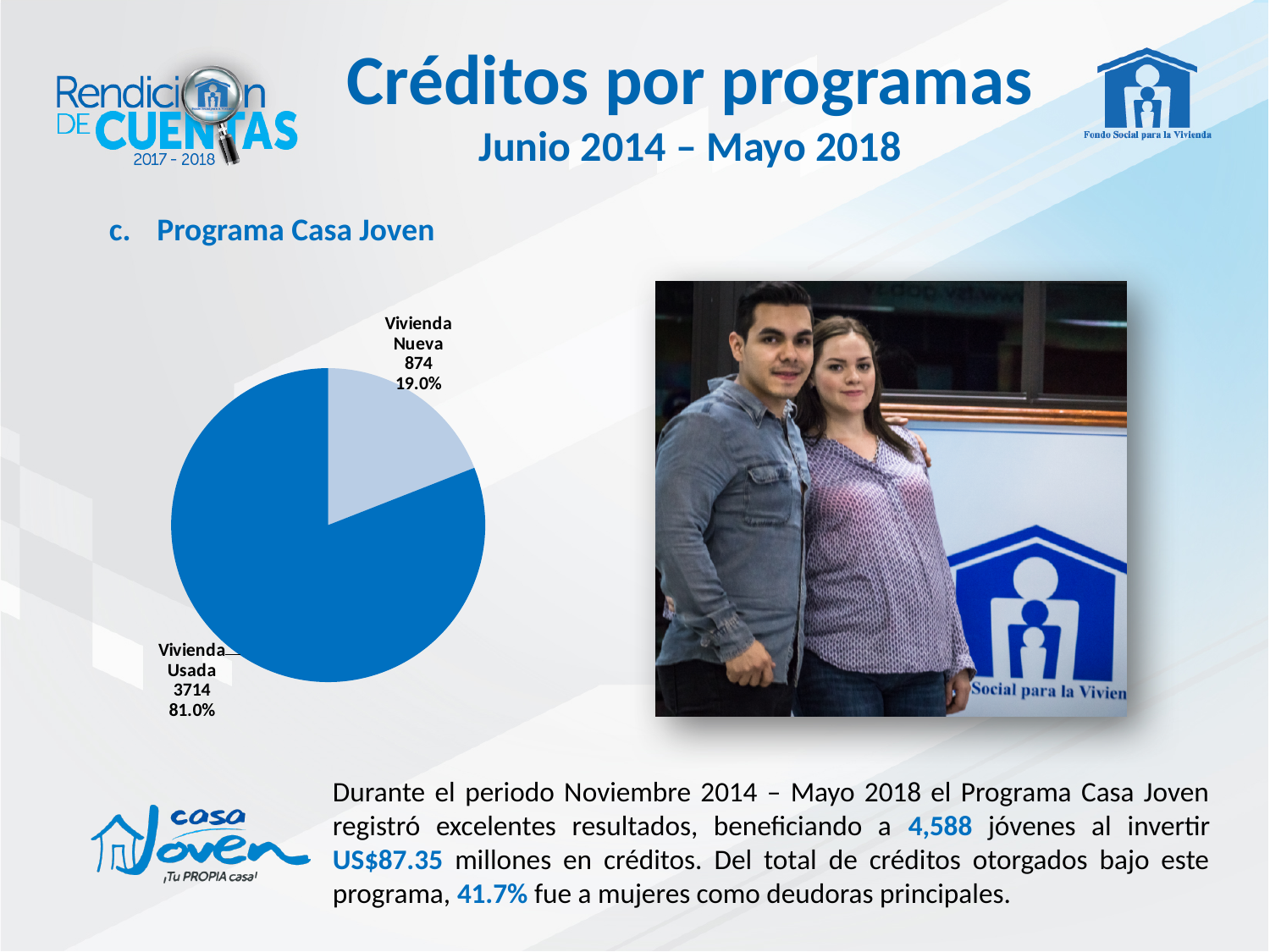
What is the total number of credits across both slices of the pie? 4588 What is the heading of the section containing the pie chart? Programa Casa Joven Which category has the largest slice of the pie? Vivienda Usada How many credits are shown for Vivienda Nueva? 874 Which is larger, Vivienda Usada or Vivienda Nueva? Vivienda Usada How many credits are shown for Vivienda Usada? 3714 What share of the pie does Vivienda Usada represent? 81.0% What share of the pie does Vivienda Nueva represent? 19.0% What type of chart is shown on the slide? Pie chart What is the difference in credits between Vivienda Usada and Vivienda Nueva? 2840 Which category has the smallest slice of the pie? Vivienda Nueva How many categories does the pie chart show? 2